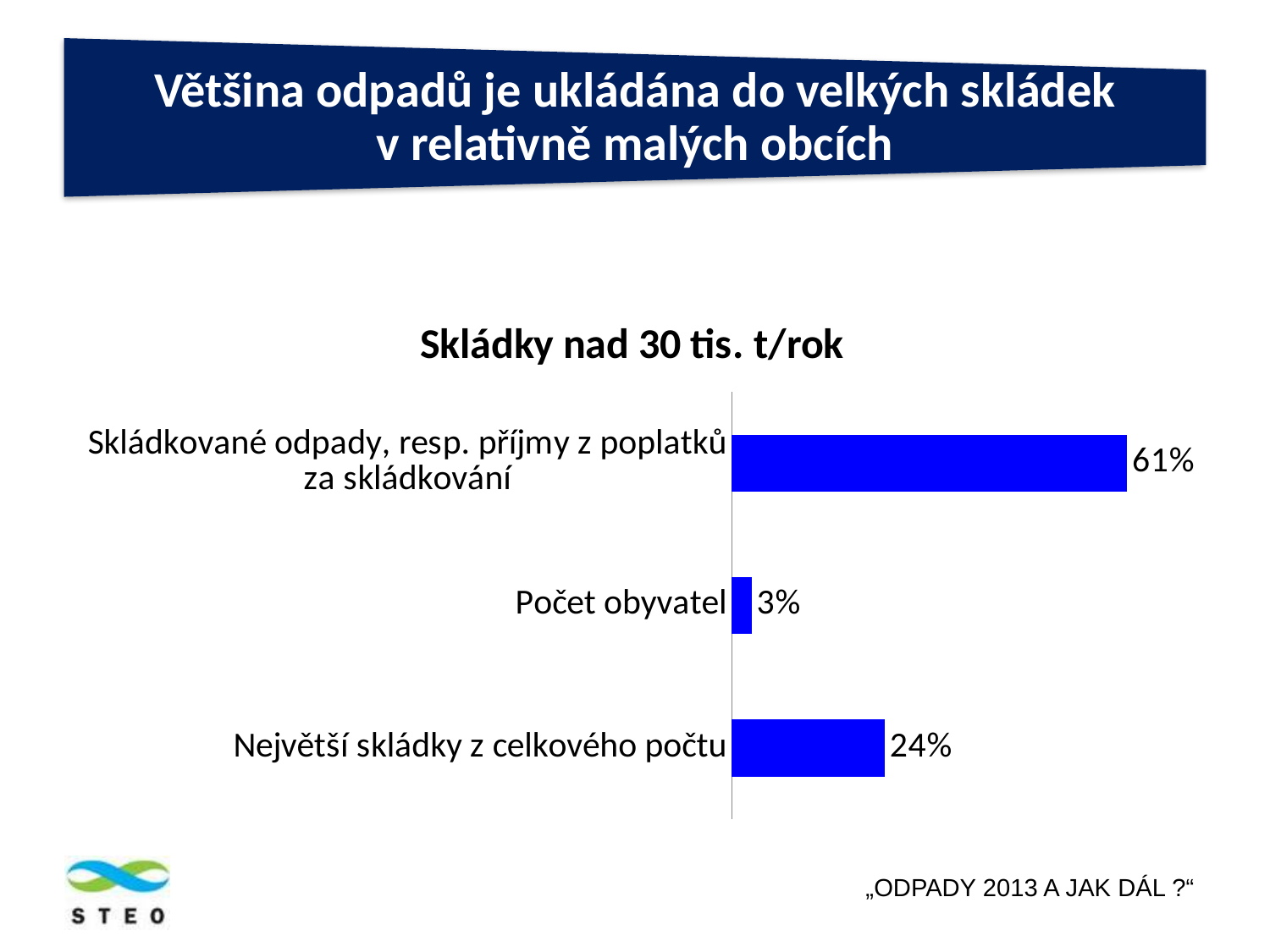
Which is larger: the value for "Počet obyvatel" or the value for "Největší skládky z celkového počtu"? Největší skládky z celkového počtu What is the difference between the value for "Skládkované odpady, resp. příjmy z poplatků za skládkování" and the value for "Největší skládky z celkového počtu"? 37% How many categories are shown in the chart? 3 What is the value for "Počet obyvatel"? 3% What is the value for "Skládkované odpady, resp. příjmy z poplatků za skládkování"? 61% What is the difference between the value for "Největší skládky z celkového počtu" and the value for "Počet obyvatel"? 21% What is the value for "Největší skládky z celkového počtu"? 24% Which category has the highest value? Skládkované odpady, resp. příjmy z poplatků za skládkování What is the title of the chart? Skládky nad 30 tis. t/rok What kind of chart is shown on the slide? Bar chart Which category has the lowest value? Počet obyvatel What colour are the bars in the chart? Blue